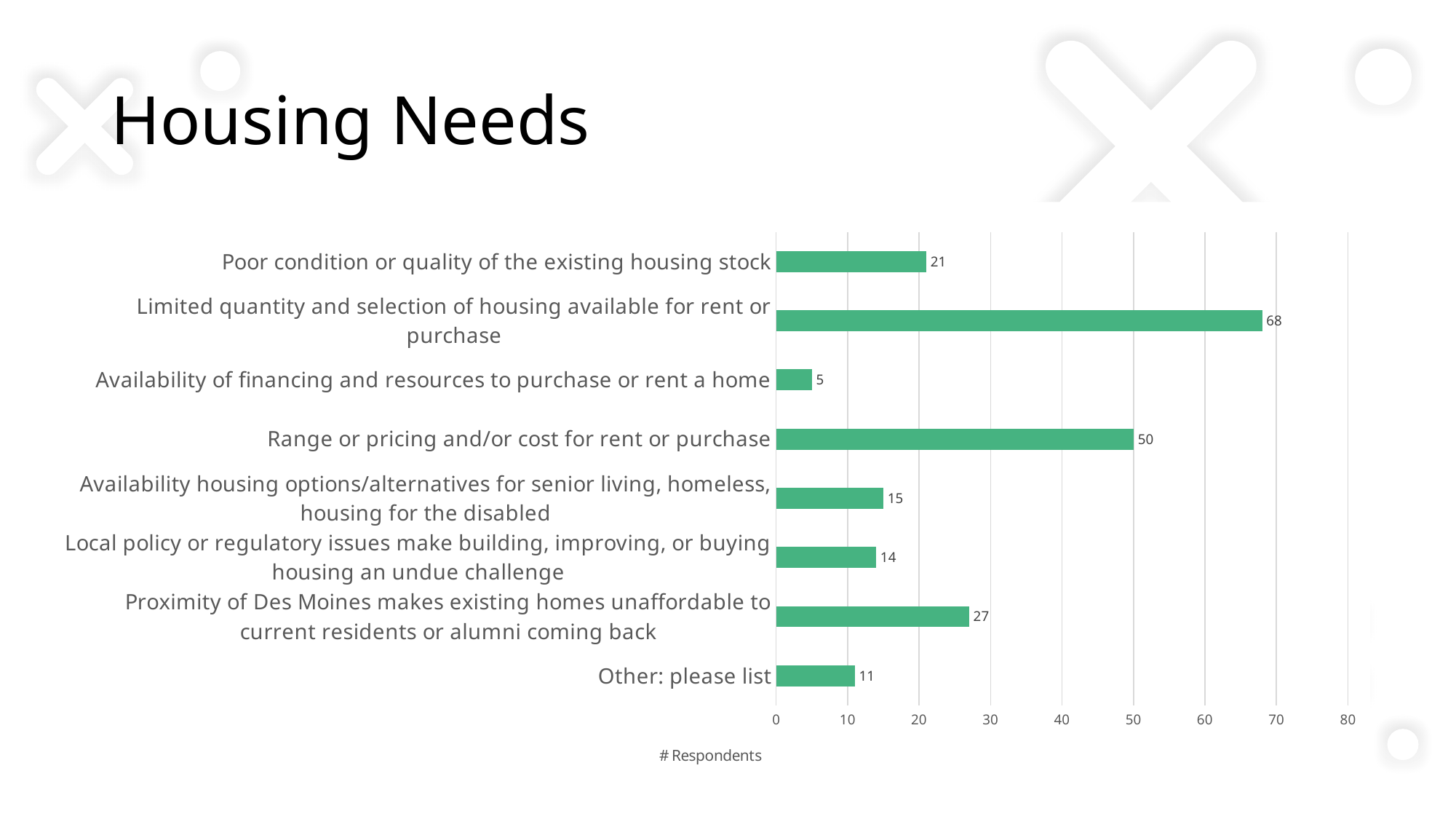
What is the label on the horizontal axis of the chart? # Respondents What kind of chart is shown on the slide? Bar chart How many respondents selected "Poor condition or quality of the existing housing stock"? 21 How many categories are shown in the chart? 8 What is the value for "Range or pricing and/or cost for rent or purchase"? 50 How many respondents chose "Other: please list"? 11 Which category has the lowest number of respondents? Availability of financing and resources to purchase or rent a home Which category has the highest number of respondents? Limited quantity and selection of housing available for rent or purchase What is the difference in respondents between "Limited quantity and selection of housing available for rent or purchase" and "Range or pricing and/or cost for rent or purchase"? 18 Is the value for "Local policy or regulatory issues make building, improving, or buying housing an undue challenge" greater or less than 20? less What is the difference between the values for "Availability housing options/alternatives for senior living, homeless, housing for the disabled" and "Local policy or regulatory issues make building, improving, or buying housing an undue challenge"? 1 Which has more respondents: "Proximity of Des Moines makes existing homes unaffordable to current residents or alumni coming back" or "Poor condition or quality of the existing housing stock"? Proximity of Des Moines makes existing homes unaffordable to current residents or alumni coming back